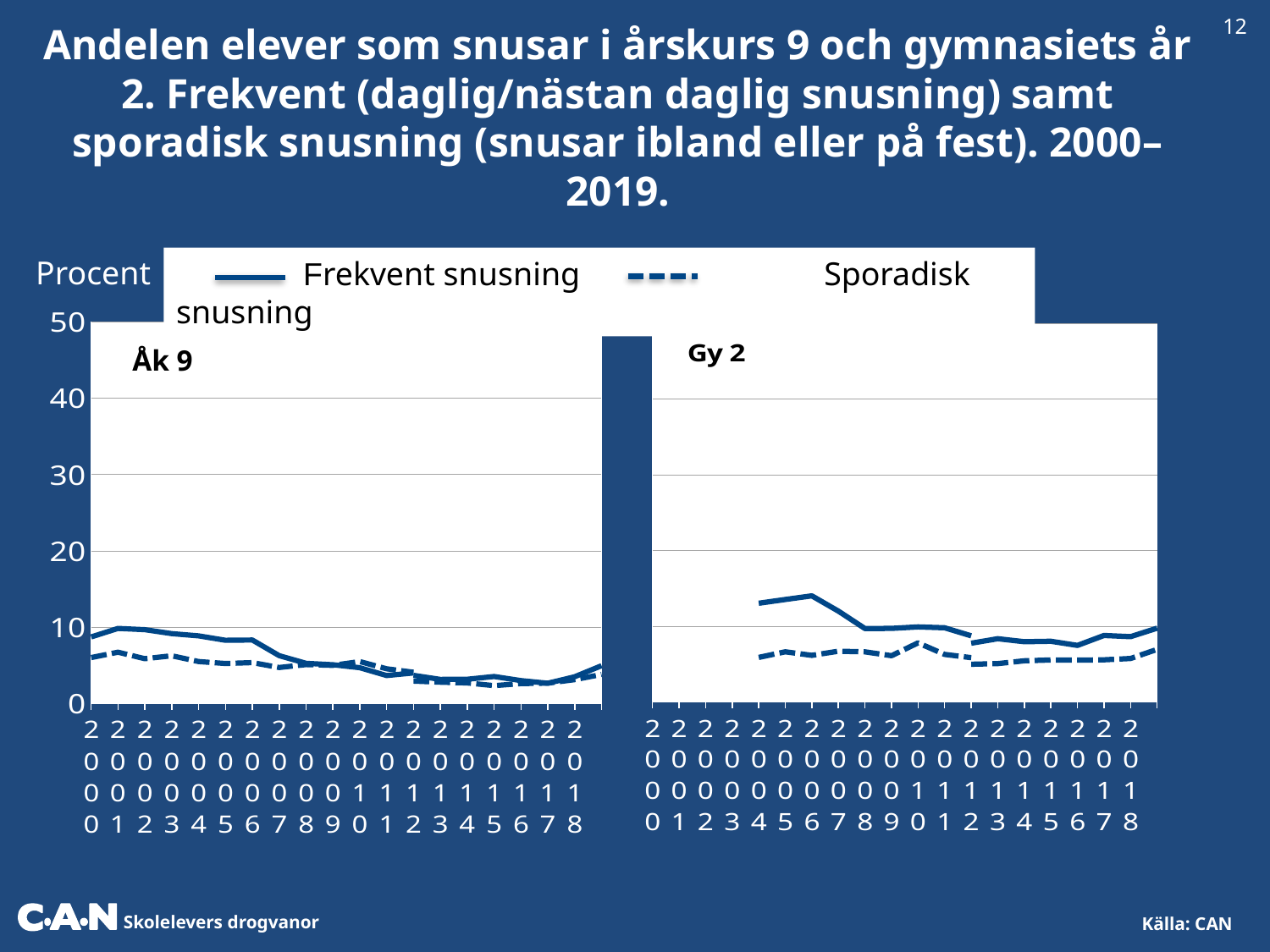
How many series does the legend list? 2 In the Gy 2 chart, is the value for Frekvent snusning in 2006 greater or less than 10? greater Which is larger in 2006: Frekvent snusning in the Gy 2 chart or Frekvent snusning in the Åk 9 chart? Gy 2 How many years are labelled on the x axis of the Åk 9 chart? 19 In the Åk 9 chart, is the value for Frekvent snusning in 2000 greater or less than 20? less In the Åk 9 chart, does Frekvent snusning rise or fall from 2000 to 2014? fall Which two series are shown in the legend? Frekvent snusning and Sporadisk snusning In the Gy 2 chart, which series has the larger value in 2006, Frekvent snusning or Sporadisk snusning? Frekvent snusning What is the label on the y axis of the charts? Procent In the Åk 9 chart, is the value for Frekvent snusning in 2014 greater or less than 10? less What kind of chart is used on this slide? Line chart